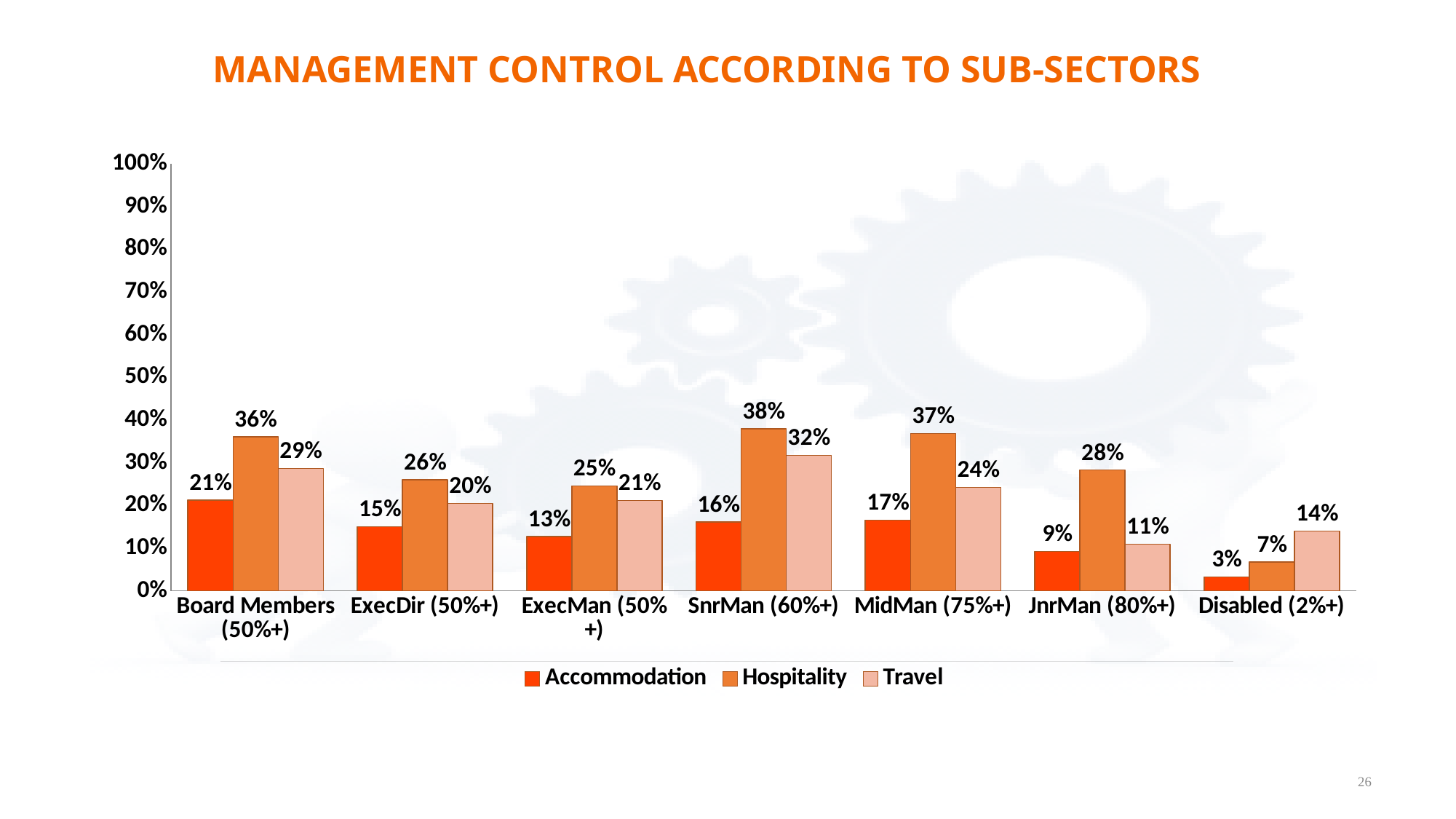
Which category has the highest Hospitality value? SnrMan (60%+) Which series is shown in the lightest colour in the legend? Travel Which category has the lowest Accommodation value? Disabled (2%+) Which is larger for JnrMan (80%+): the Hospitality value or the Travel value? Hospitality How many categories are shown on the x axis? 7 What is the Travel value for Disabled (2%+)? 14% What is the difference between the Hospitality and Accommodation values for MidMan (75%+)? 20% How many series does the legend list? 3 What kind of chart is shown on the slide? Bar chart What is the title of the chart? MANAGEMENT CONTROL ACCORDING TO SUB-SECTORS What is the Accommodation value for Board Members (50%+)? 21% What is the Hospitality value for SnrMan (60%+)? 38%